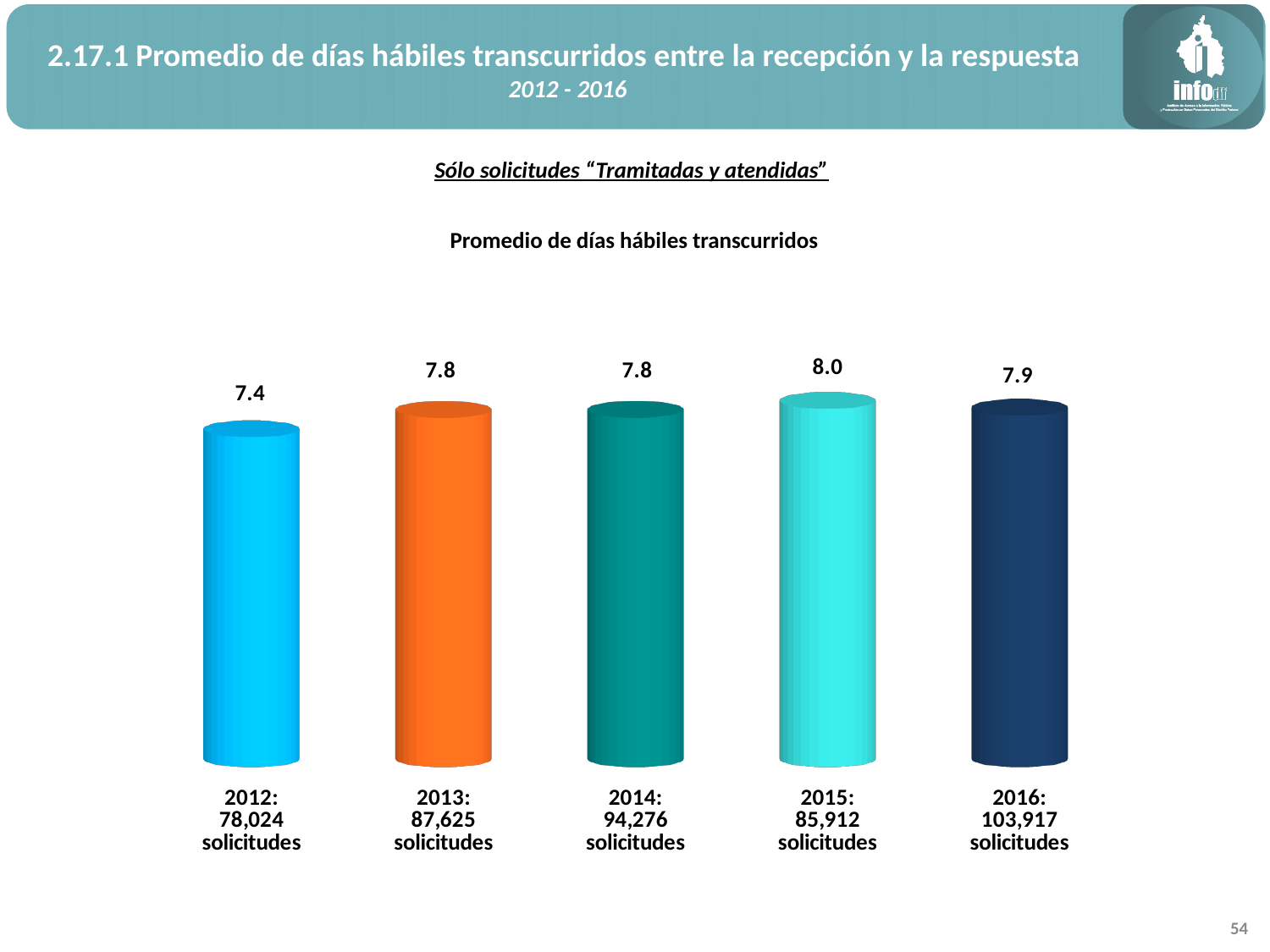
What is the average number of business days for 2015? 8.0 Do the values for 2013 and 2014 differ? No, both are 7.8 What is the difference between the values for 2015 and 2012? 0.6 Which year has the lowest average number of business days? 2012 Which year has the highest average number of business days? 2015 How many years are shown in the chart? 5 What is the title of the chart? Promedio de días hábiles transcurridos How many solicitudes are listed for 2014 in the category label? 94,276 Which is larger, the value for 2016 or the value for 2013? 2016 What is the average number of business days for 2012? 7.4 What kind of chart is shown on the slide? bar chart What is the average number of business days for 2016? 7.9